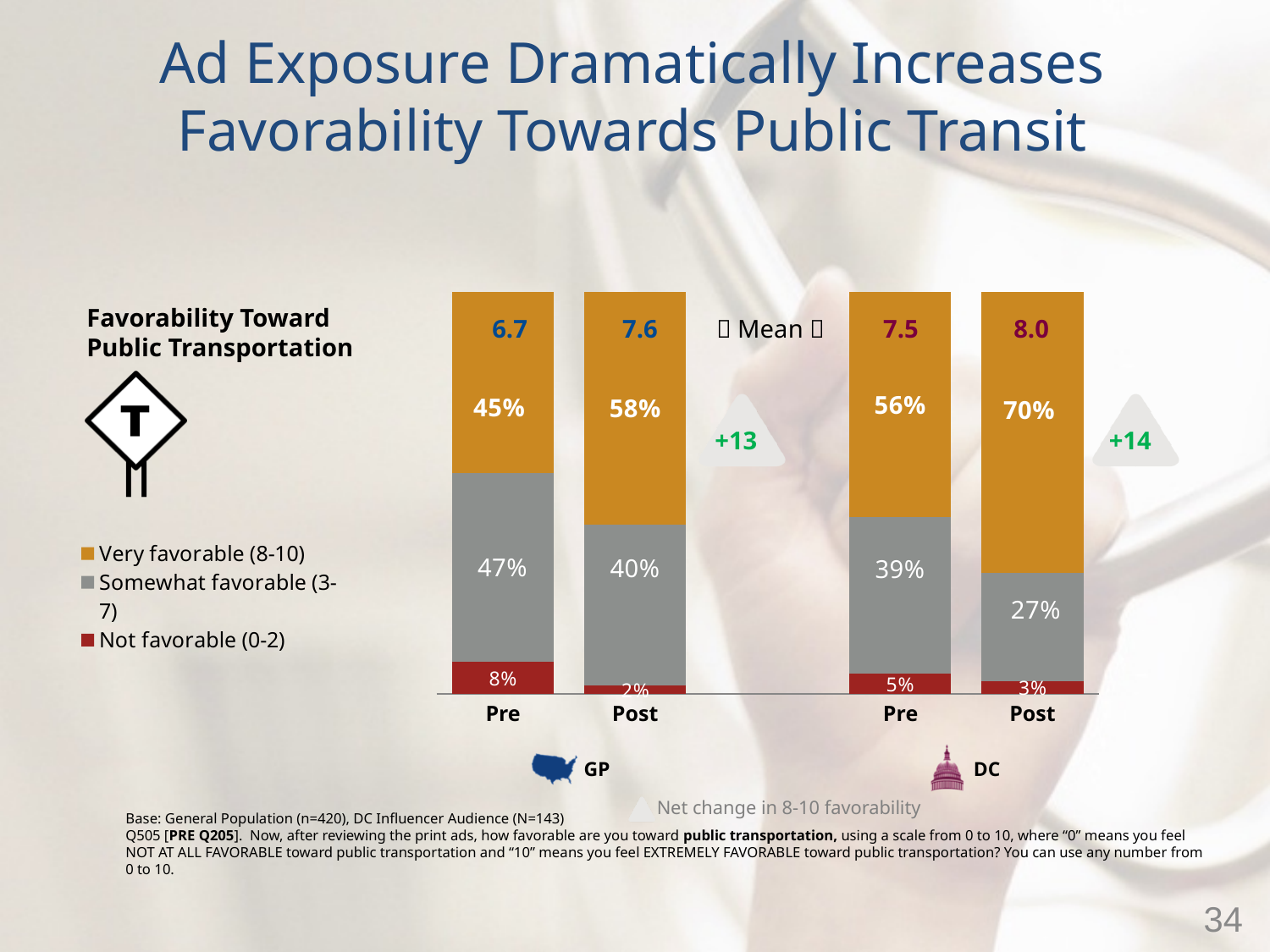
How many bars are shown in the chart? 4 What type of chart is shown on the slide? Stacked bar chart How many series does the legend list? 3 Which bar has the lowest Not favorable (0-2) percentage? GP Post What percentage of the GP Pre group is Very favorable (8-10)? 45% What is the difference in Very favorable (8-10) percentage between GP Post and GP Pre? 13 percentage points Which bar has the highest Very favorable (8-10) percentage? DC Post What percentage of the DC Post group is Very favorable (8-10)? 70% What is the Somewhat favorable (3-7) percentage for the DC Post bar? 27% Which is larger, the Somewhat favorable (3-7) share for GP Pre or for DC Pre? GP Pre What percentage of the GP Pre group is Not favorable (0-2)? 8% What is the mean favorability score shown for the DC Pre bar? 7.5